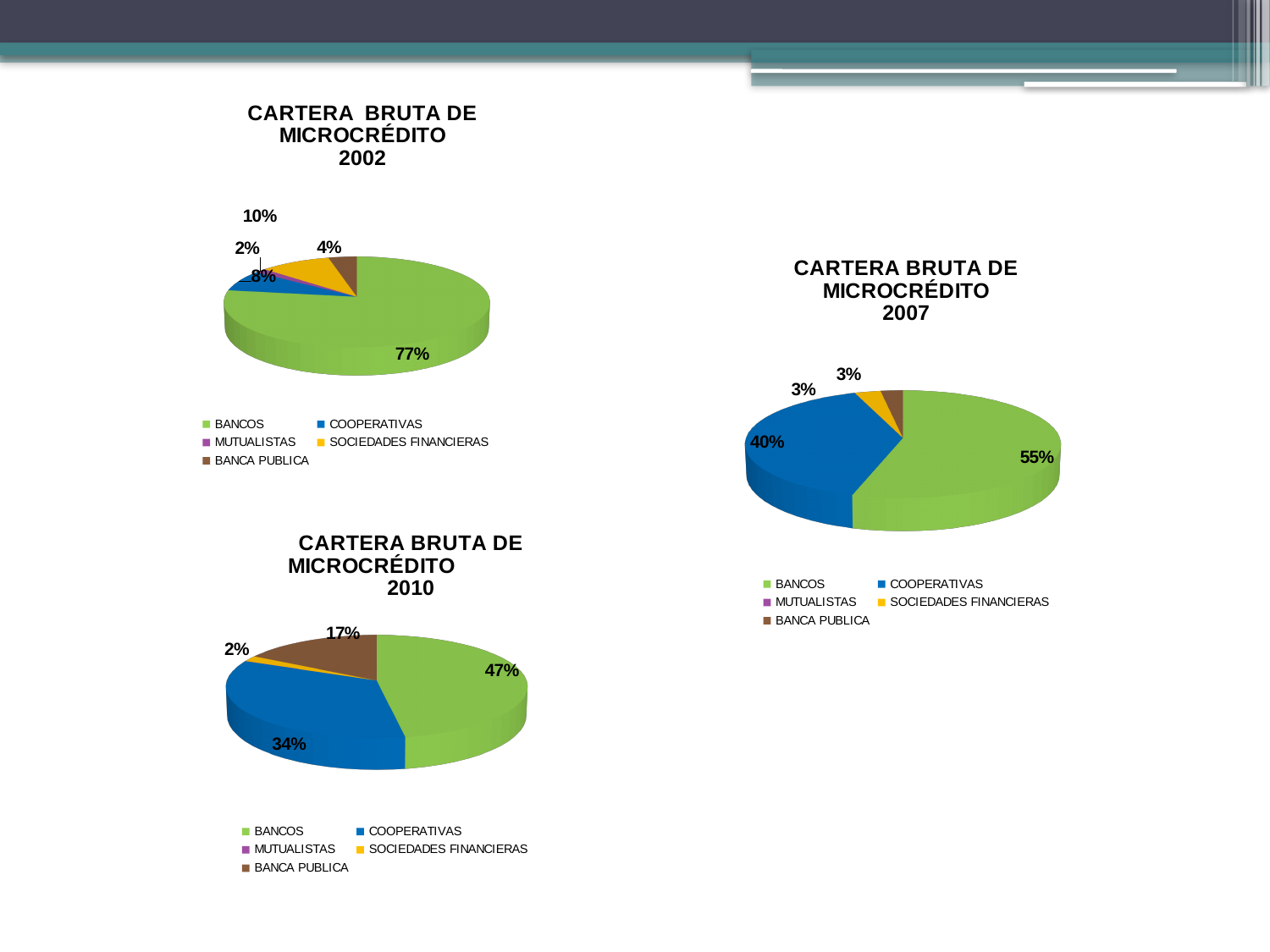
In the 2002 chart (CARTERA BRUTA DE MICROCRÉDITO 2002), what share does BANCOS hold? 77% How many entries does the legend of the 2002 chart list? 5 In the 2007 chart, what share does BANCOS hold? 55% In the 2010 chart (CARTERA BRUTA DE MICROCRÉDITO 2010), what share does BANCA PUBLICA hold? 17% In the 2007 chart (CARTERA BRUTA DE MICROCRÉDITO 2007), what share does COOPERATIVAS hold? 40% In the 2010 chart, which is larger, the share of BANCOS or the share of COOPERATIVAS? BANCOS In the 2010 chart, what share does COOPERATIVAS hold? 34% In the 2007 chart, what is the difference in percentage points between BANCOS and COOPERATIVAS? 15 In the 2010 chart, which category has the largest share? BANCOS In the 2010 chart, which labelled category has the smallest share? SOCIEDADES FINANCIERAS What type of chart is used for CARTERA BRUTA DE MICROCRÉDITO 2007? Pie chart In the 2002 chart, what share does COOPERATIVAS hold? 8%